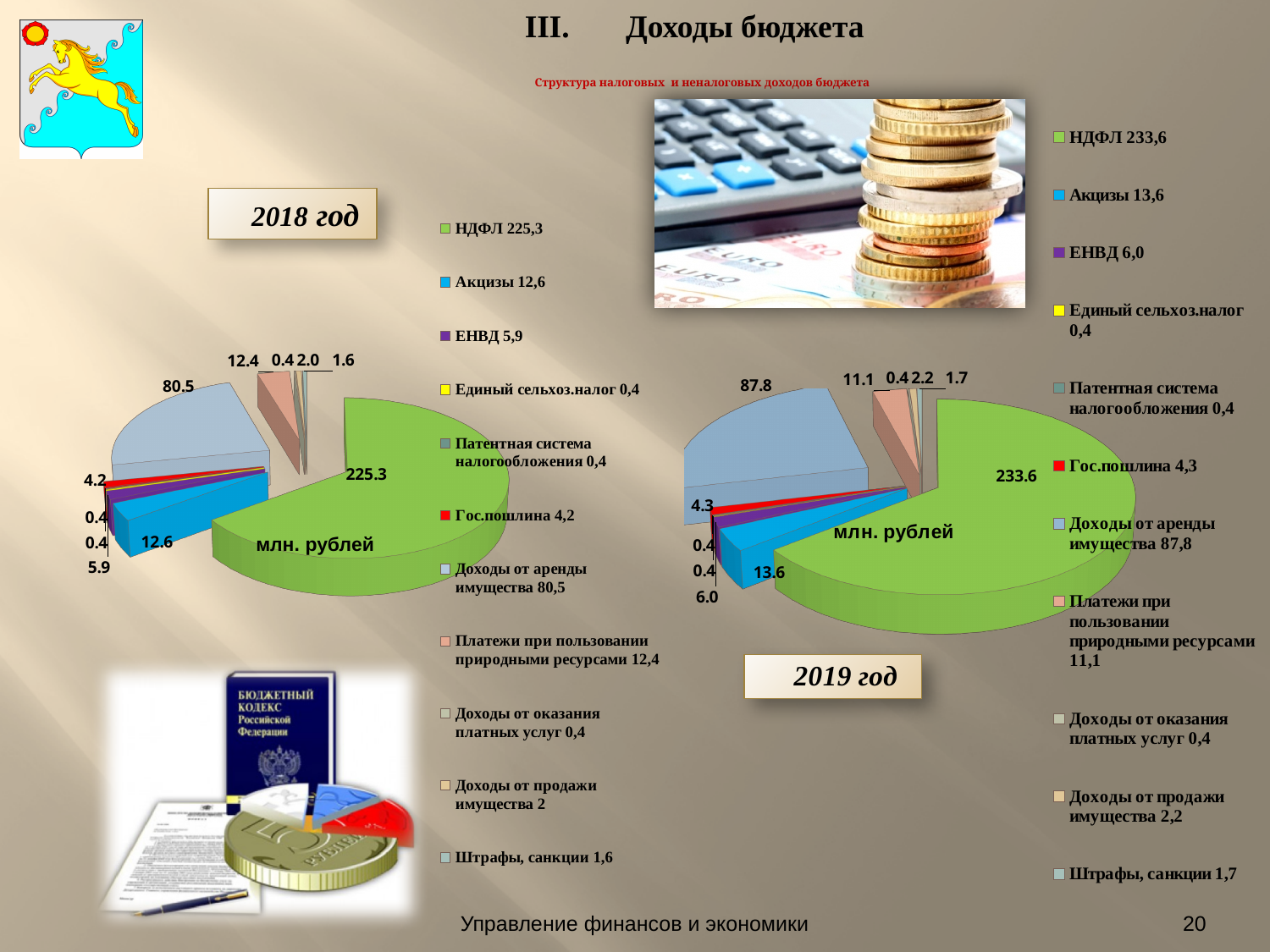
In the 2019 год chart, what is the value for Гос.пошлина? 4.3 In the 2019 год chart, what is the value for Акцизы? 13.6 In the 2019 год chart, which category has the largest value? НДФЛ What type of chart is used for the 2018 год data? pie chart In the 2018 год chart, what is the value for НДФЛ? 225.3 What is the difference between the НДФЛ value in the 2019 год chart and the НДФЛ value in the 2018 год chart? 8.3 How many categories does the legend of the 2019 год chart list? 11 In the 2018 год chart, which category has the second largest value? Доходы от аренды имущества In the 2019 год chart, what is the value for Доходы от аренды имущества? 87.8 What unit is shown in the centre of both pie charts? млн. рублей In the 2018 год chart, what is the value for Платежи при пользовании природными ресурсами? 12.4 In the 2018 год chart, which is larger: Акцизы or ЕНВД? Акцизы